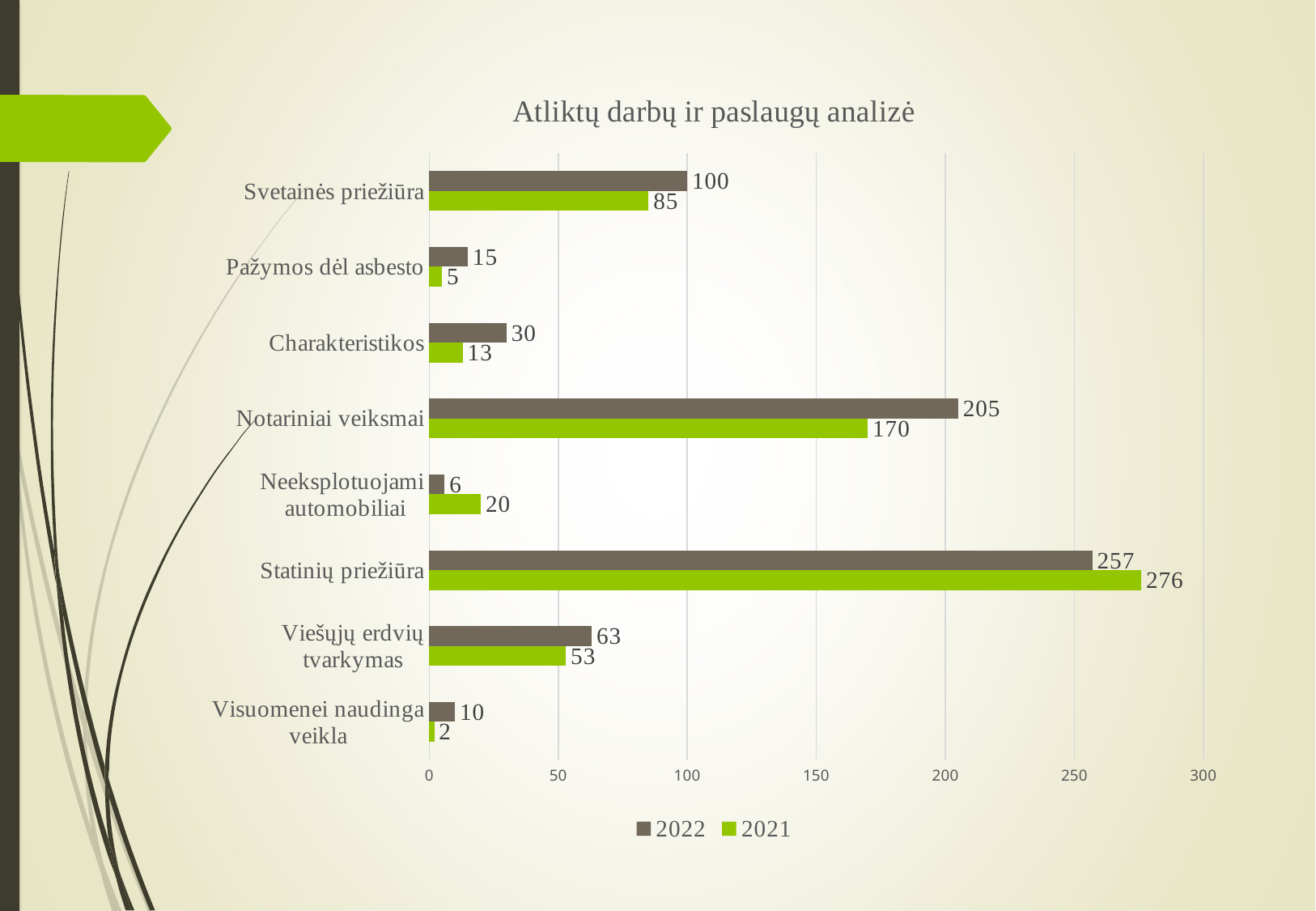
What is the difference between the 2022 and 2021 values for Svetainės priežiūra? 15 Which category has the lowest 2021 value? Visuomenei naudinga veikla What kind of chart is shown on the slide? bar chart Is the 2021 value for Notariniai veiksmai greater or less than 150? greater What is the 2022 value for Notariniai veiksmai? 205 How many categories are shown on the chart? 8 What is the 2021 value for Statinių priežiūra? 276 Which is larger for Neeksplotuojami automobiliai, the 2022 value or the 2021 value? 2021 What is the title of the chart? Atliktų darbų ir paslaugų analizė What is the 2021 value for Neeksplotuojami automobiliai? 20 Which category has the highest 2022 value? Statinių priežiūra How many series does the legend list? 2